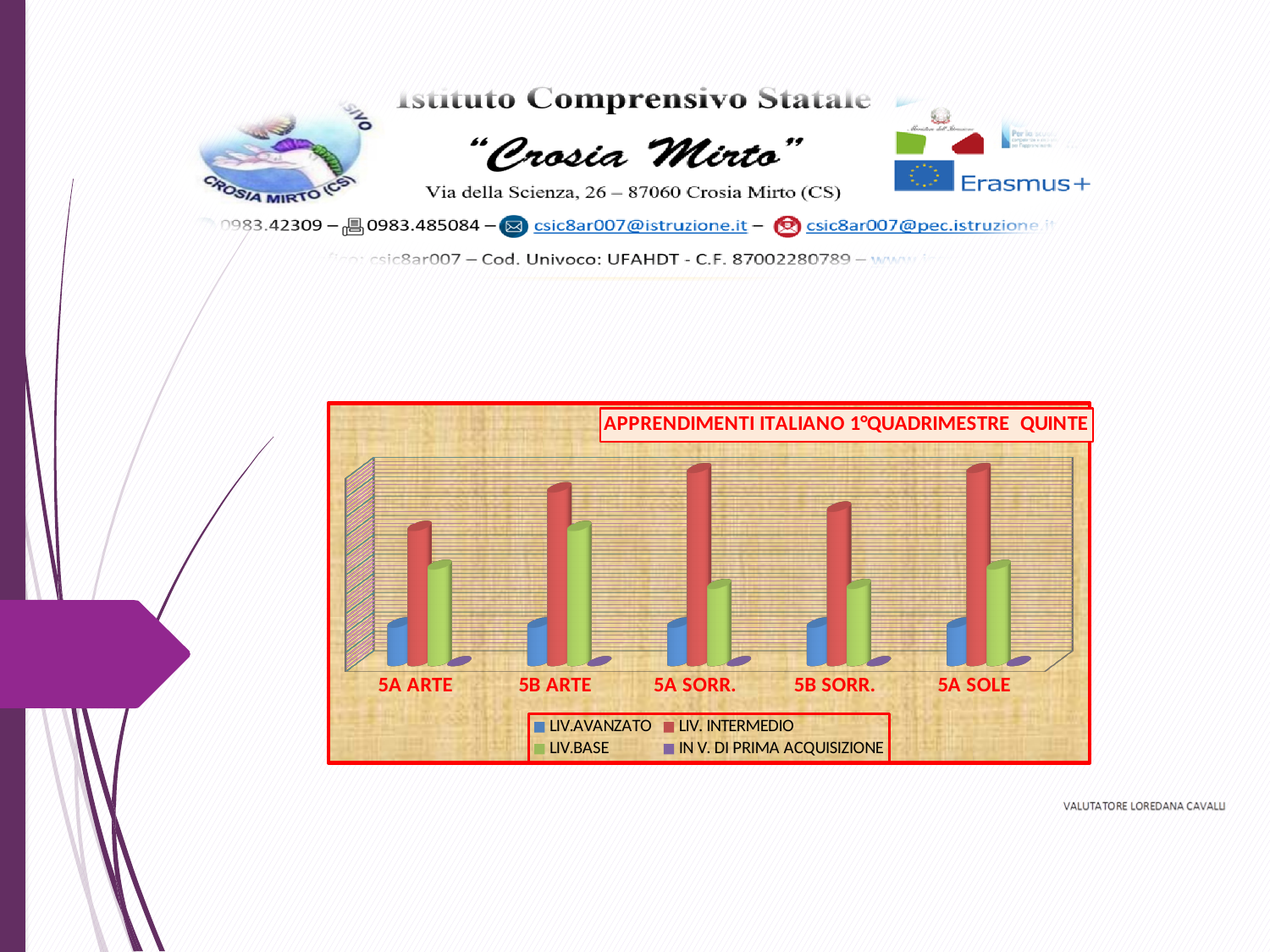
Which class has the lowest LIV. INTERMEDIO value? 5A ARTE How many series does the chart legend list? 4 Which class has the larger LIV. INTERMEDIO value: 5A SORR. or 5B SORR.? 5A SORR. Which series is represented by the red bars in the chart? LIV. INTERMEDIO For 5A ARTE, which is larger: LIV. INTERMEDIO or LIV.BASE? LIV. INTERMEDIO Which series has the tallest bar in every class shown in the chart? LIV. INTERMEDIO How many classes (categories) are shown on the x axis of the chart? 5 What is the title of the chart? APPRENDIMENTI ITALIANO 1°QUADRIMESTRE QUINTE Which class has the highest LIV.BASE value? 5B ARTE What kind of chart is shown on the slide? Bar chart Which class has the larger LIV.BASE value: 5B ARTE or 5A SOLE? 5B ARTE Which series has the lowest value in every class shown in the chart? IN V. DI PRIMA ACQUISIZIONE